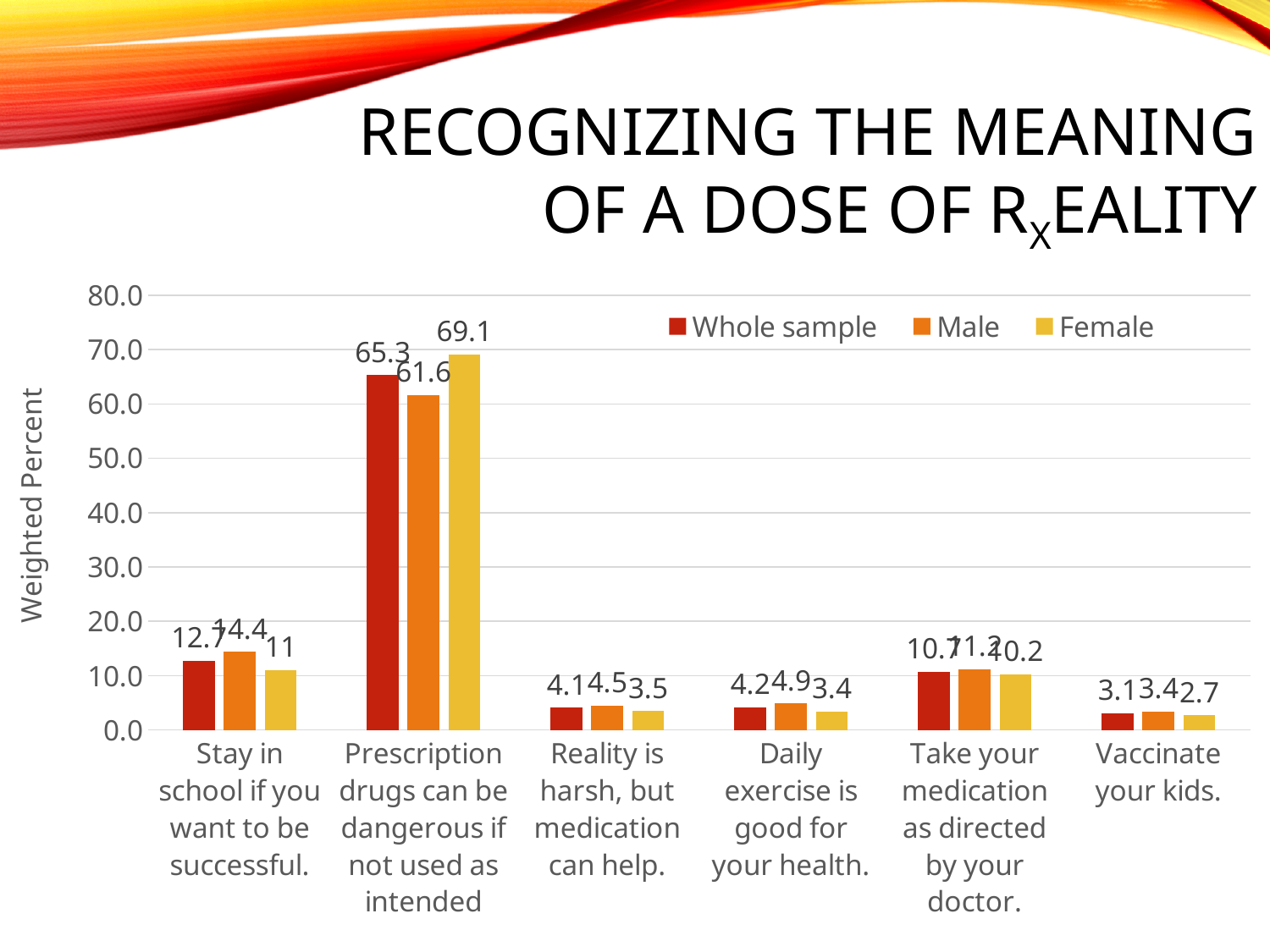
Which category has the highest Whole sample value? Prescription drugs can be dangerous if not used as intended What is the Male value for "Daily exercise is good for your health."? 4.9 What is the Whole sample value for "Prescription drugs can be dangerous if not used as intended"? 65.3 How many series does the legend list? 3 What is the title of the vertical axis? Weighted Percent Is the Whole sample value for "Prescription drugs can be dangerous if not used as intended" greater or less than 60.0? greater Which category has the lowest Female value? Vaccinate your kids. What is the Female value for "Prescription drugs can be dangerous if not used as intended"? 69.1 What kind of chart is shown on the slide? bar chart How many statement categories are shown on the x axis? 6 For "Prescription drugs can be dangerous if not used as intended", what is the difference between the Female and Male values? 7.5 For "Prescription drugs can be dangerous if not used as intended", which is larger, the Male value or the Female value? Female